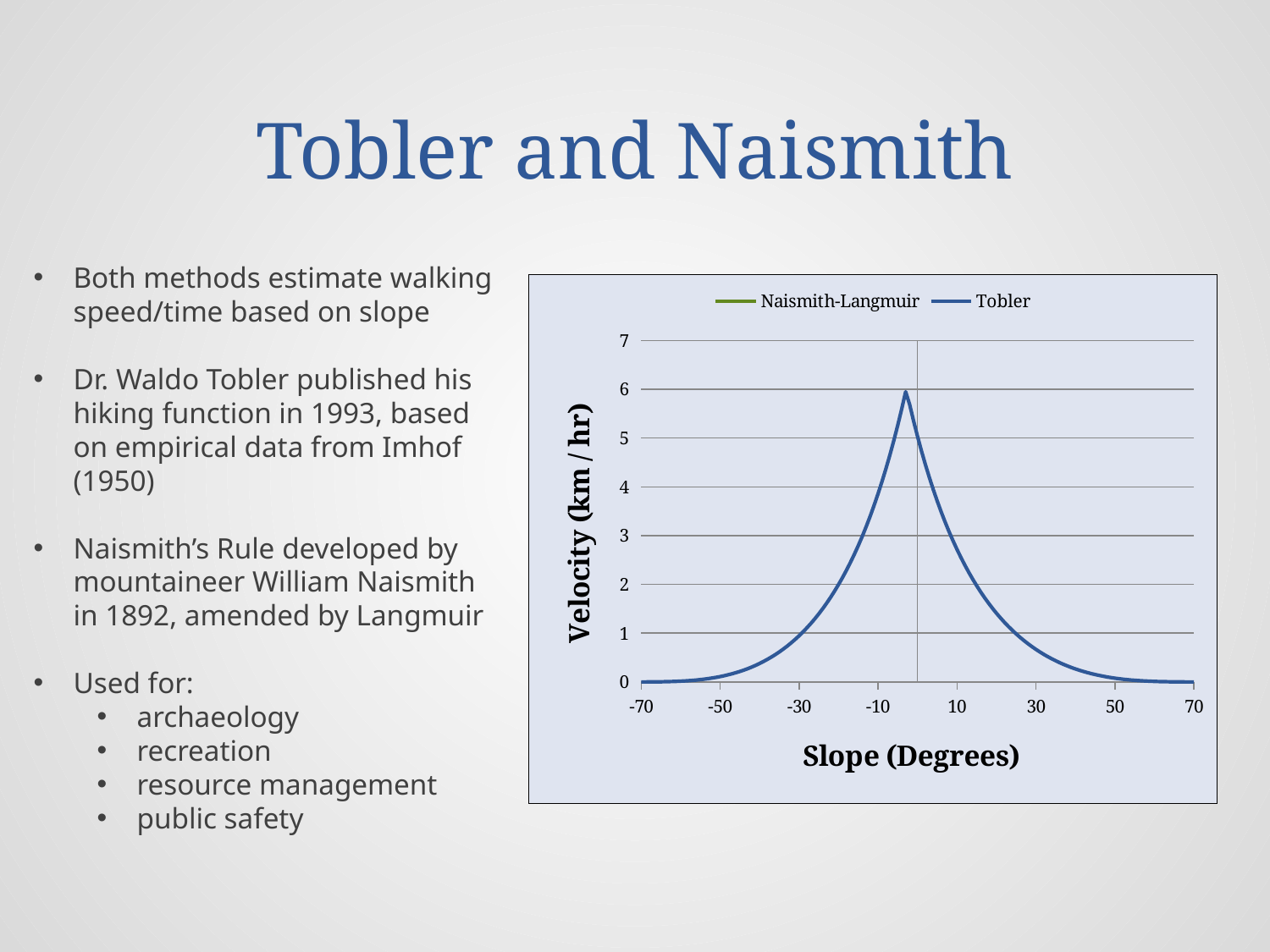
Is the peak velocity of the Tobler curve greater or less than 5? greater Is the Tobler velocity higher at a slope of 10 degrees or at a slope of 50 degrees? 10 degrees Is the Tobler velocity at a slope of 50 degrees greater or less than 1? less Is the Tobler velocity at a slope of 30 degrees greater or less than 2? less What is the title of the chart's vertical axis? Velocity (km / hr) What are the two series named in the chart legend? Naismith-Langmuir and Tobler Does the Tobler velocity rise or fall as slope increases from 10 to 70 degrees? fall What kind of chart is shown on the slide? line chart How many series does the chart legend list? 2 Does the Tobler velocity rise or fall as slope increases from -70 to -10 degrees? rise